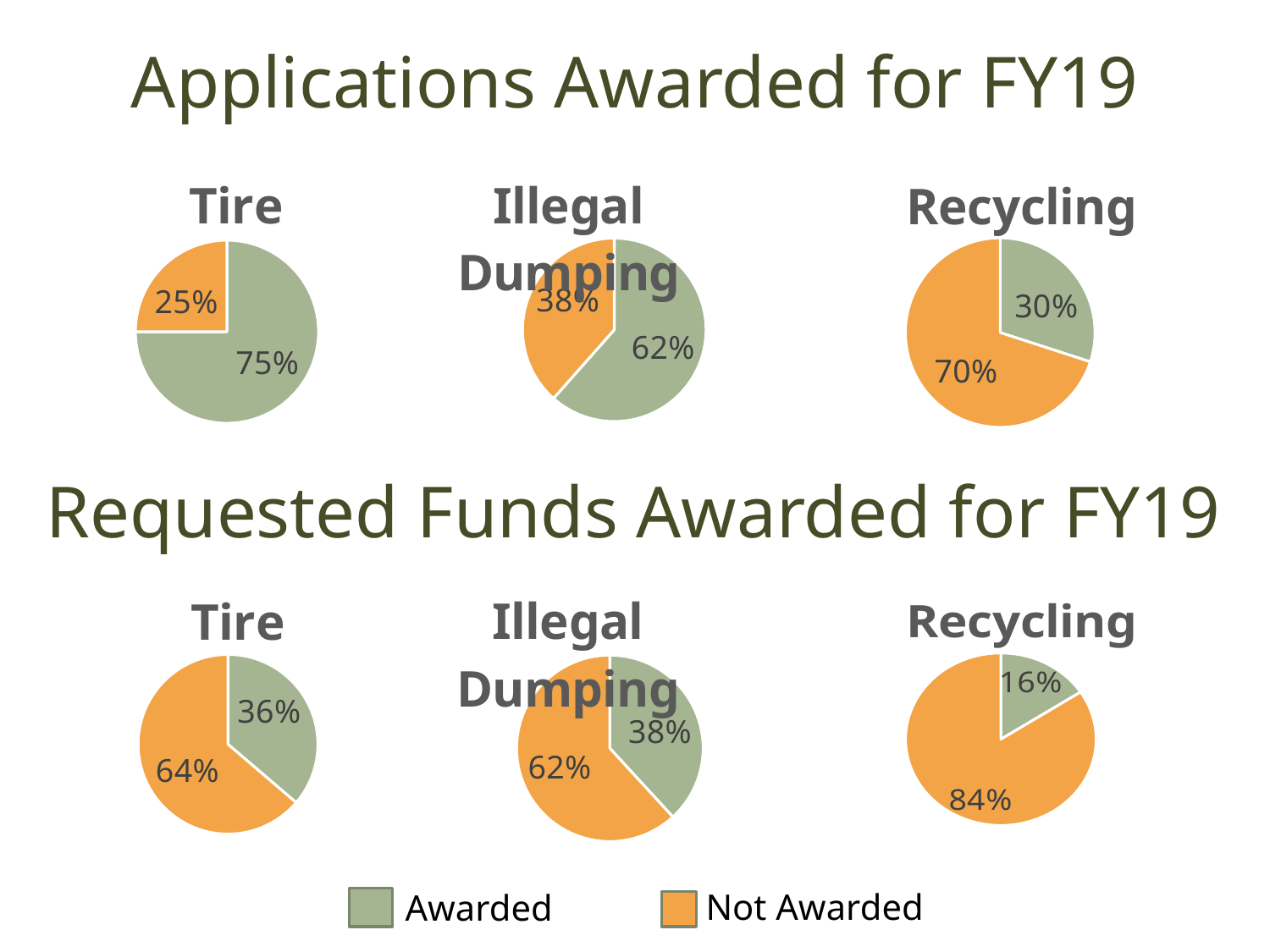
In the Applications Awarded for FY19 Recycling pie chart, what share was Awarded? 30% In the Requested Funds Awarded for FY19 Recycling pie chart, what share was Not Awarded? 84% In the Requested Funds Awarded for FY19 Illegal Dumping pie chart, what share was Awarded? 38% What kind of chart is used for the Tire chart under Applications Awarded for FY19? Pie chart In the Applications Awarded for FY19 Tire pie chart, what is the difference between the Awarded and Not Awarded shares? 50% Across the three Requested Funds Awarded for FY19 pie charts, which category has the lowest Awarded share? Recycling In the Applications Awarded for FY19 Recycling pie chart, which slice is larger, Awarded or Not Awarded? Not Awarded How many entries does the legend at the bottom of the slide list? 2 Across the three Applications Awarded for FY19 pie charts, which category has the highest Awarded share? Tire